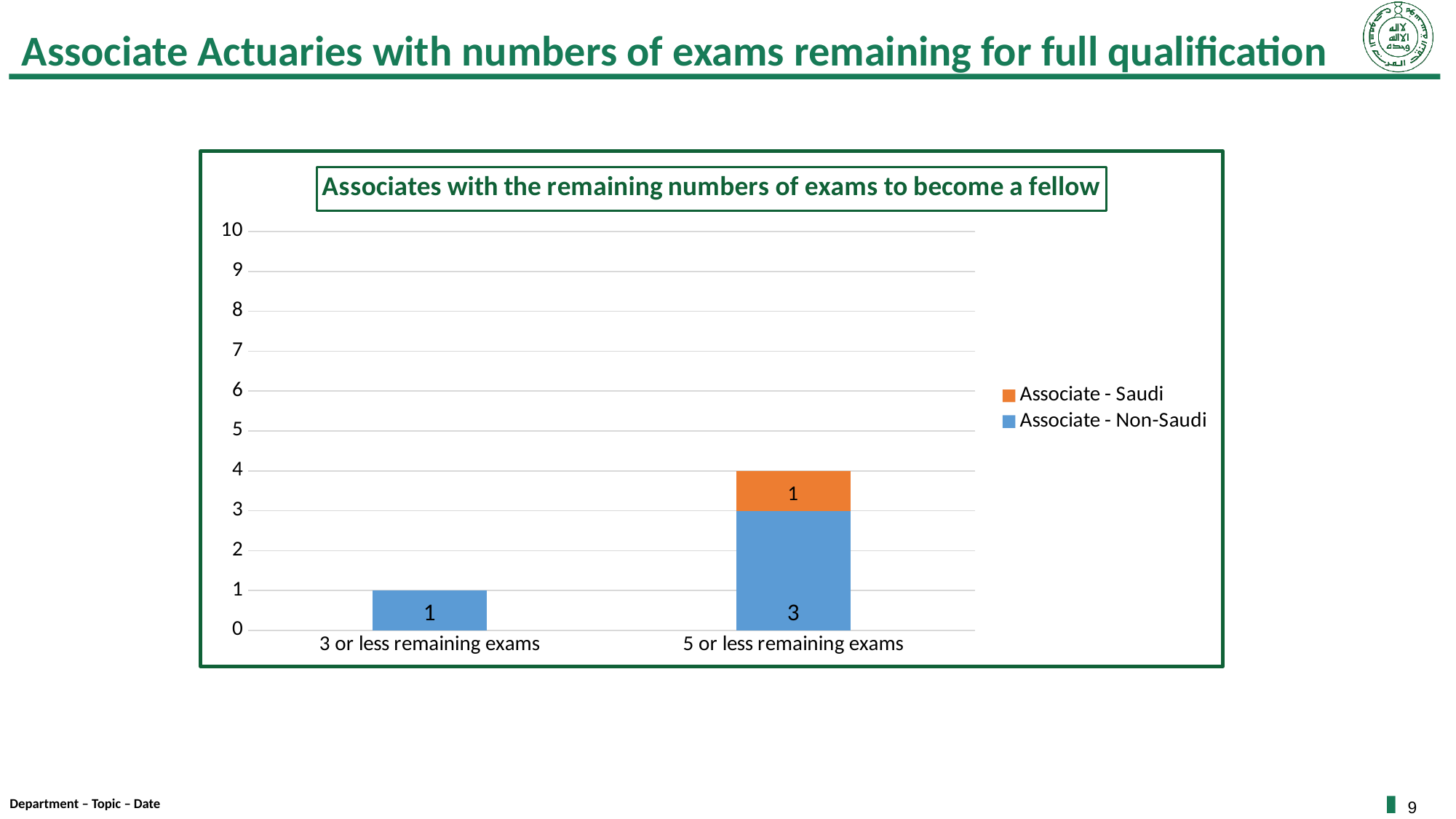
What is the value for Associate - Non-Saudi in the '3 or less remaining exams' category? 1 How many series does the legend list? 2 How many categories are shown on the x axis? 2 What is the value for Associate - Saudi in the '5 or less remaining exams' category? 1 Which colour represents Associate - Saudi in the legend? Orange What kind of chart is shown on the slide? Stacked bar chart What is the total of the stacked bar for '5 or less remaining exams'? 4 What is the title of the chart? Associates with the remaining numbers of exams to become a fellow What is the difference between the Associate - Non-Saudi values for '5 or less remaining exams' and '3 or less remaining exams'? 2 What is the value for Associate - Non-Saudi in the '5 or less remaining exams' category? 3 Which is larger in the '5 or less remaining exams' category: Associate - Saudi or Associate - Non-Saudi? Associate - Non-Saudi Which category has the higher Associate - Non-Saudi value? 5 or less remaining exams